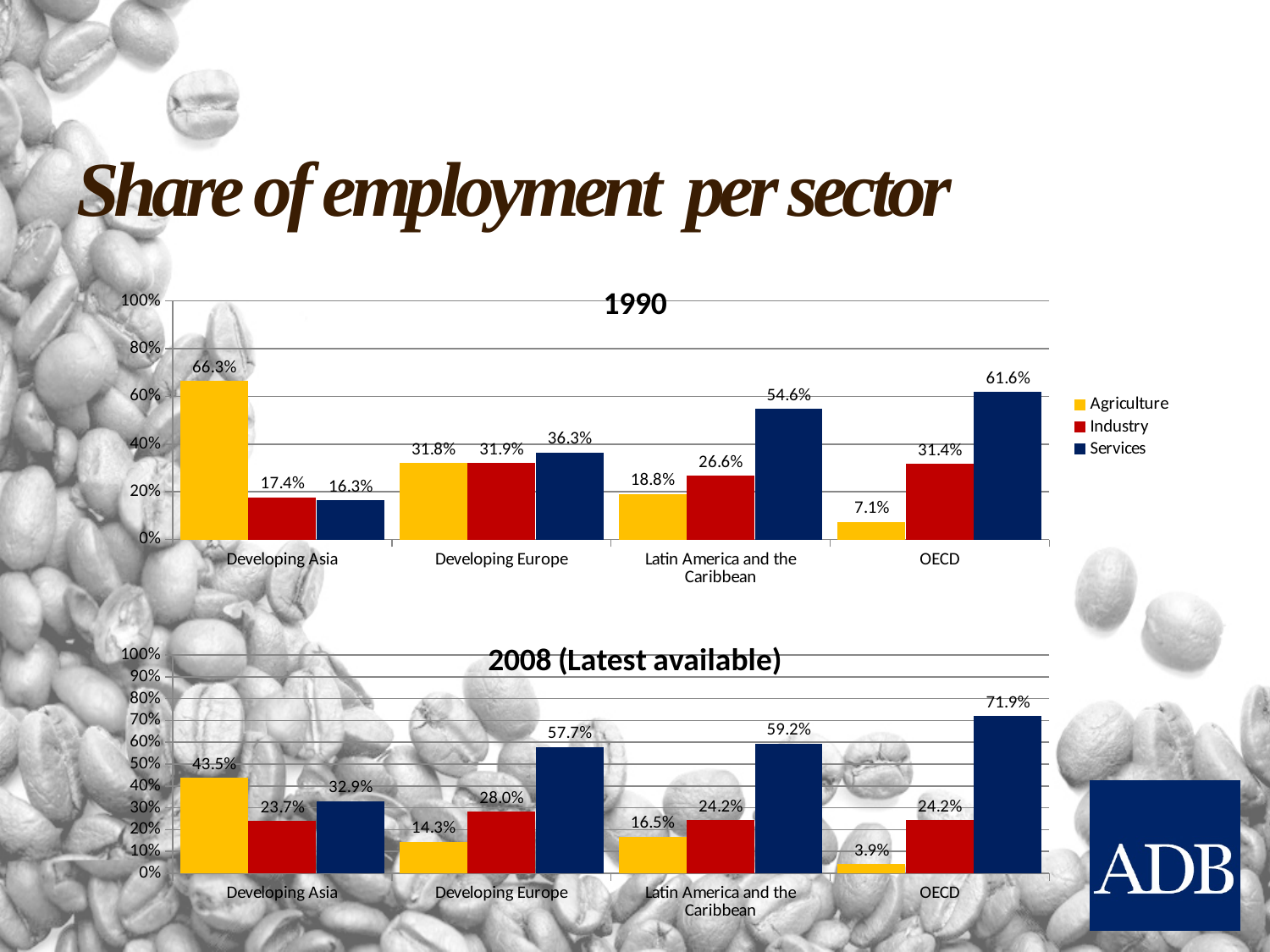
In the 1990 chart, what is the Services share for OECD? 61.6% What kind of chart is the 1990 chart? Bar chart In the 2008 (Latest available) chart, which region has the highest Services share? OECD In the 2008 (Latest available) chart, which is larger for Developing Asia: the Industry share or the Services share? Services In the 2008 (Latest available) chart, what is the Agriculture share for Developing Europe? 14.3% In the 1990 chart, which colour represents Industry in the legend? Red In the 1990 chart, what is the Agriculture share for Developing Asia? 66.3% In the 1990 chart, which region has the lowest Agriculture share? OECD How many regions are shown on the x axis of the 2008 (Latest available) chart? 4 In the 2008 (Latest available) chart, what is the Services share for OECD? 71.9% How many series does the legend on the 1990 chart list? 3 In the 1990 chart, what is the difference between the Services share for OECD and the Services share for Latin America and the Caribbean? 7.0%